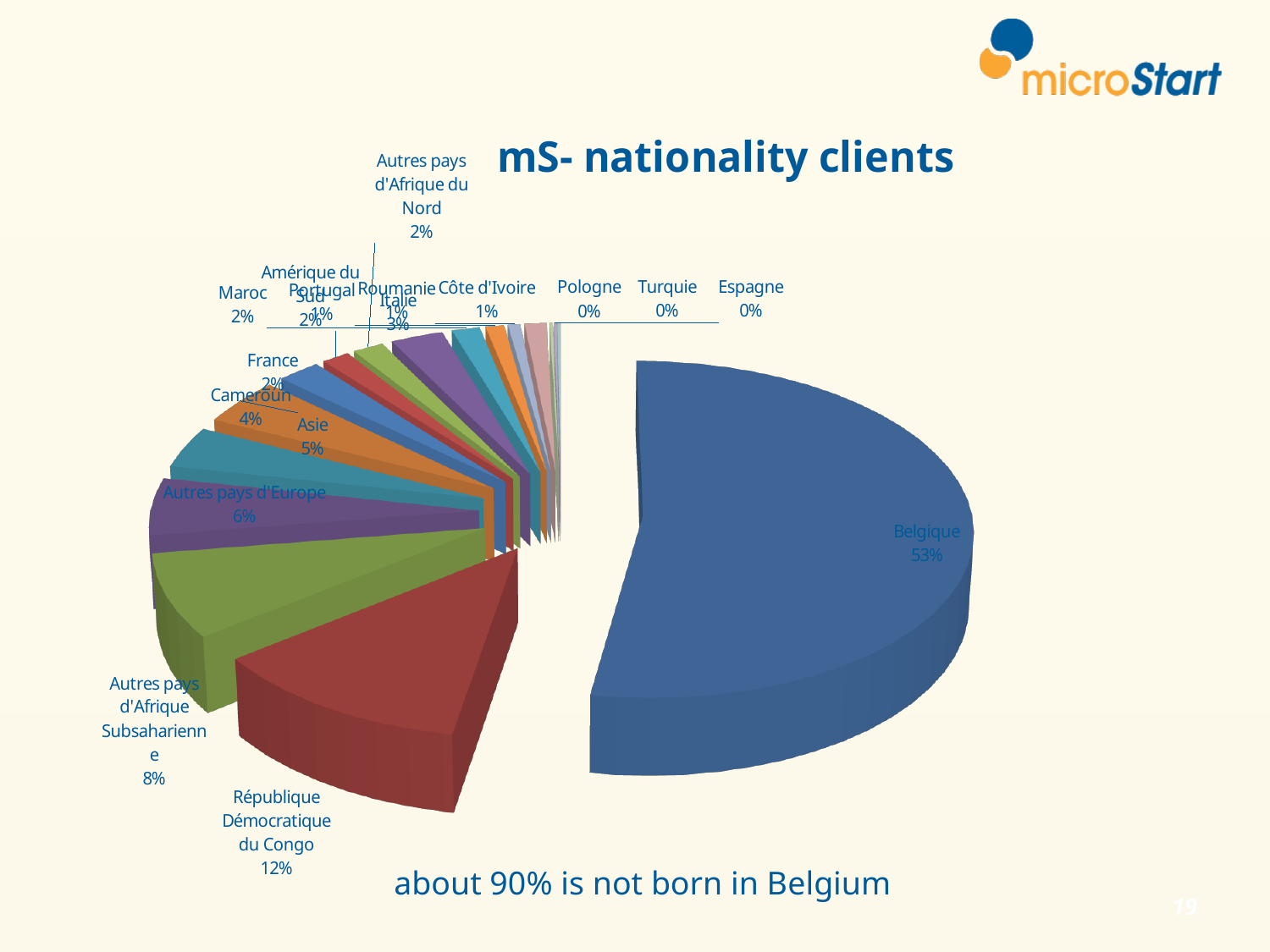
What percentage is shown for Cameroun? 4% What is the title of the chart? mS- nationality clients What percentage is shown for Autres pays d'Europe? 6% What kind of chart is shown on the slide? Pie chart What percentage is shown for Asie? 5% Which categories are labelled with 0%? Pologne, Turquie, Espagne Which is larger, the share for Asie or the share for Cameroun? Asie How many percentage points larger is the Belgique share than the République Démocratique du Congo share? 41 What percentage is shown for République Démocratique du Congo? 12% What share of clients is labelled for Belgique? 53% What percentage is shown for Autres pays d'Afrique Subsaharienne? 8% Which nationality has the largest slice of the pie? Belgique